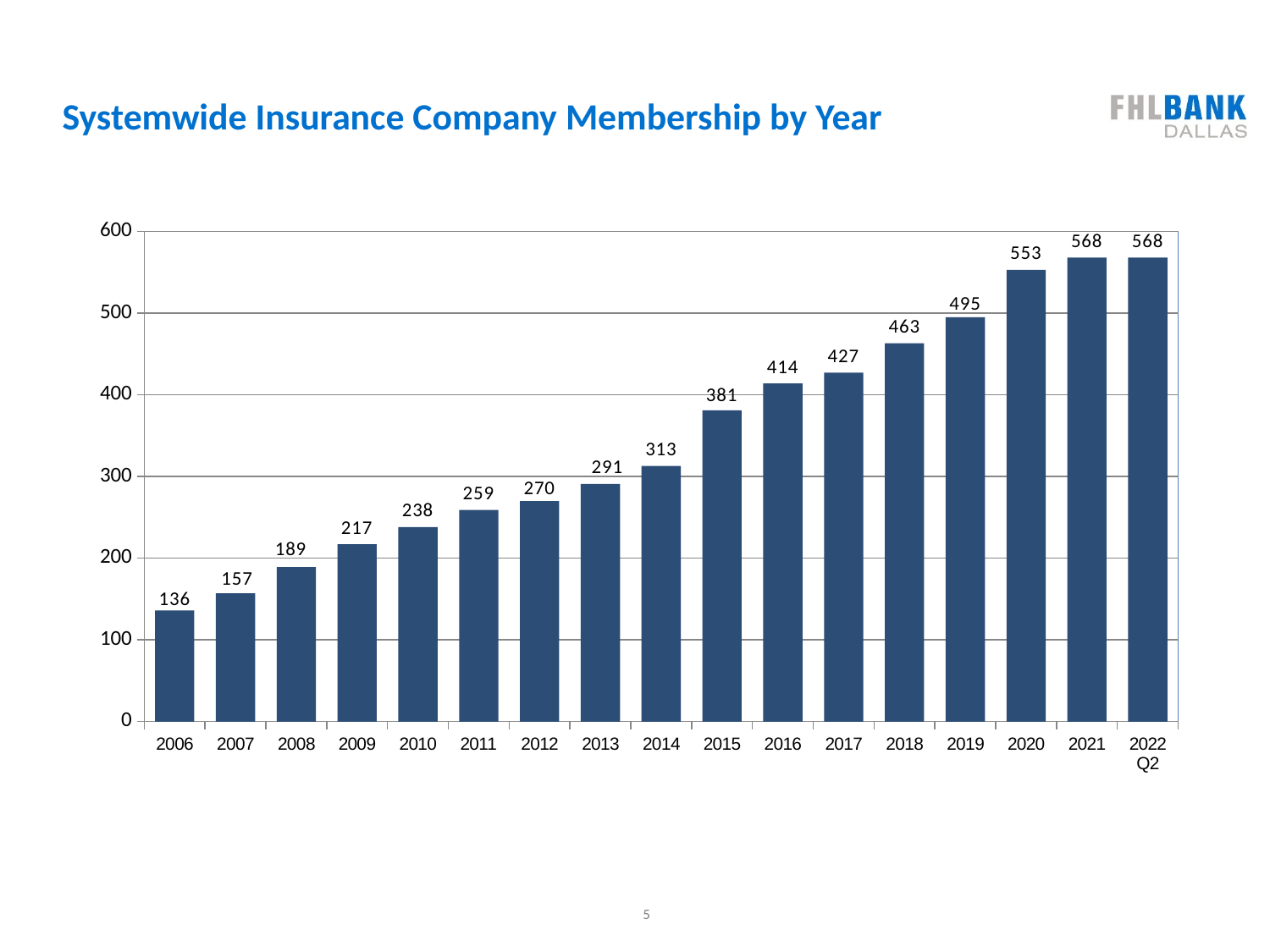
What is the value for 2019? 495 What is the difference between the values for 2014 and 2013? 22 How many bars are shown on the chart? 17 What kind of chart is shown on the slide? bar chart Which is larger, the value for 2012 or the value for 2016? 2016 What is the difference between the values for 2020 and 2010? 315 Which year has the lowest value? 2006 What is the value for 2006? 136 Do the values generally rise or fall from 2006 to 2022 Q2? rise Is the value for 2018 greater or less than 400? greater What is the value for 2015? 381 What is the highest value shown on the chart? 568